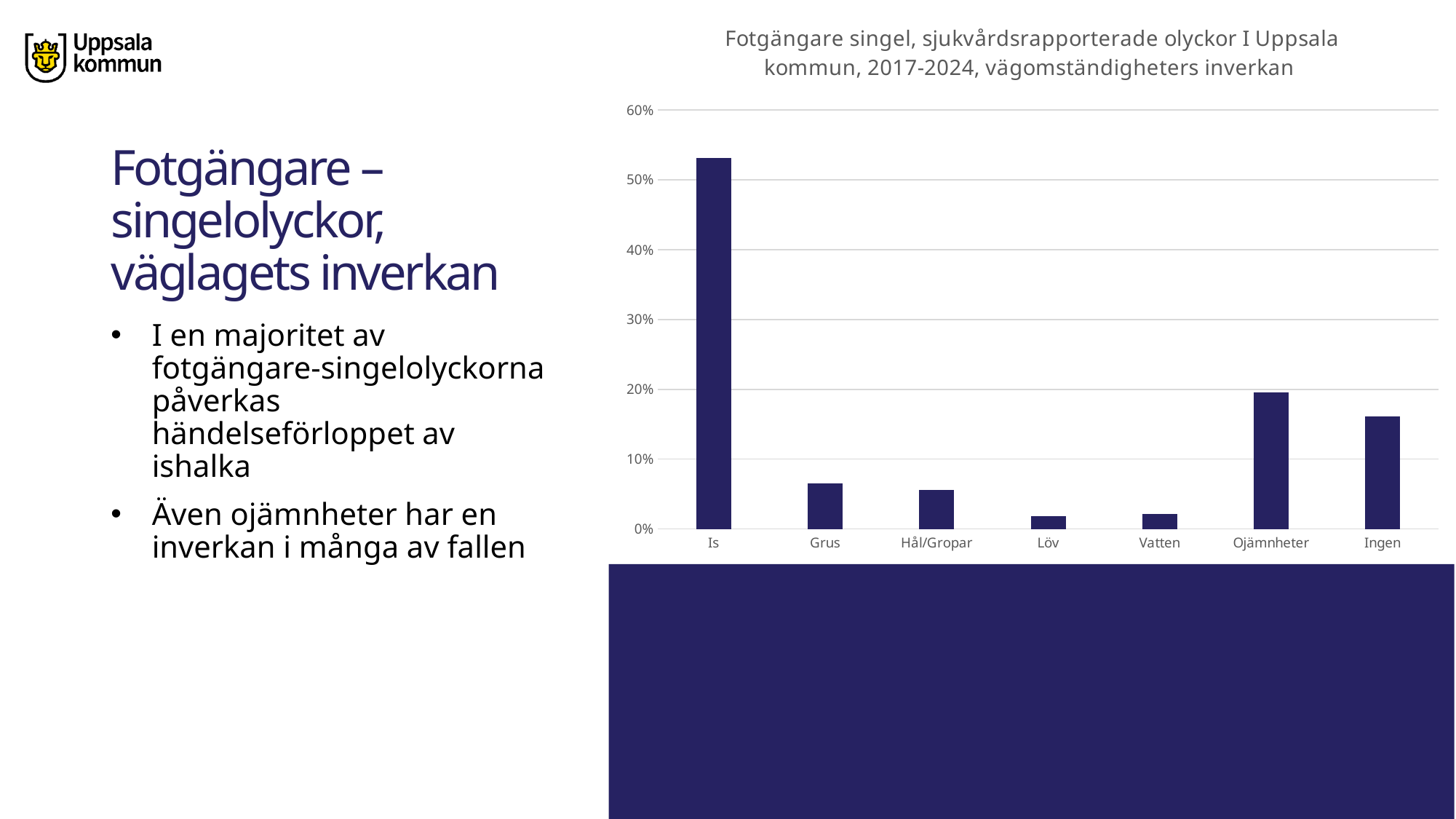
How many categories are shown on the x axis of the chart? 7 Is the value for Hål/Gropar greater or less than 10%? less Is the value for Grus greater or less than 10%? less What is the title of the chart? Fotgängare singel, sjukvårdsrapporterade olyckor I Uppsala kommun, 2017-2024, vägomständigheters inverkan What kind of chart is shown on the slide? bar chart Which is larger, the value for Ojämnheter or the value for Ingen? Ojämnheter Is the value for Ingen greater or less than 10%? greater Which category has the highest value in the chart? Is Which is larger, the value for Is or the value for Ojämnheter? Is Which is larger, the value for Grus or the value for Löv? Grus